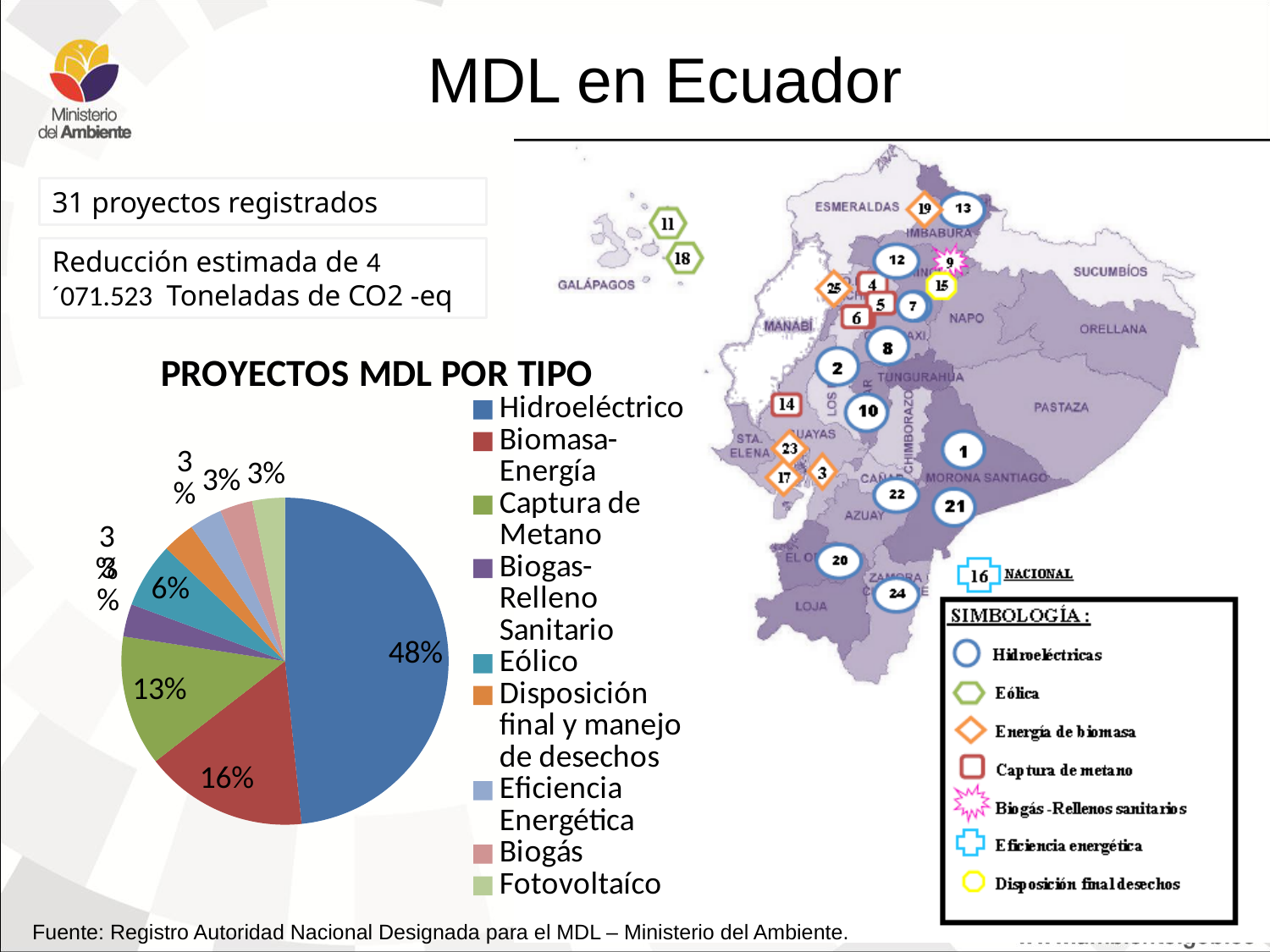
What share of the pie does Fotovoltaico represent? 3% Which slice is larger in the pie chart, Captura de Metano or Eólico? Captura de Metano How many entries does the legend of the pie chart list? 9 What percentage of the pie chart corresponds to Eólico? 6% How many project types (slices) does the pie chart show? 9 What is the difference in percentage points between the Hidroeléctrico slice and the Biomasa-Energía slice? 32 What kind of chart is shown under the title 'PROYECTOS MDL POR TIPO'? pie chart What percentage of the pie chart corresponds to Captura de Metano? 13% What is the title of the pie chart on the slide? PROYECTOS MDL POR TIPO Which project type has the largest slice in the pie chart? Hidroeléctrico What percentage of the pie chart corresponds to Biomasa-Energía? 16% What percentage of the pie chart corresponds to Hidroeléctrico? 48%